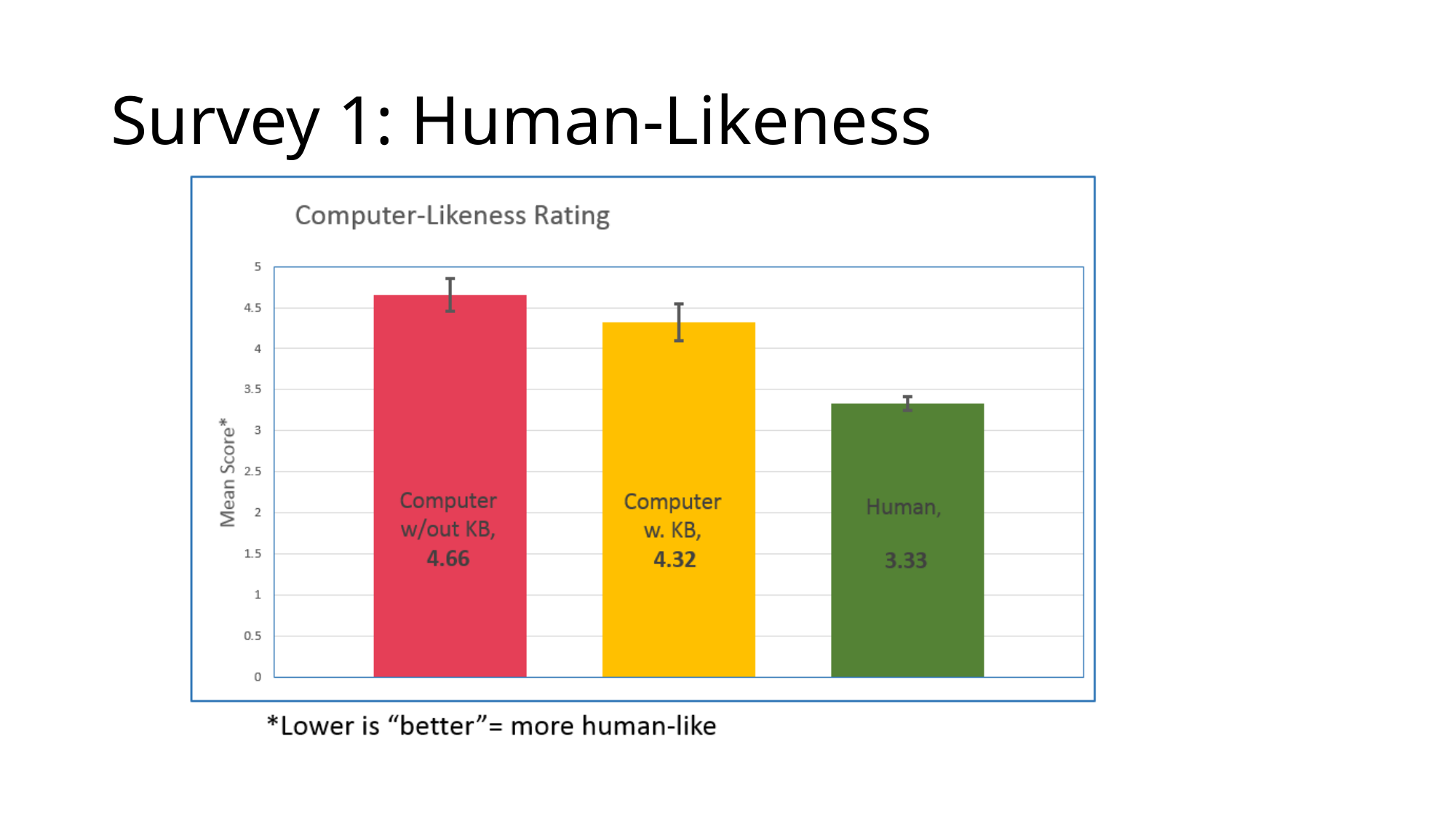
What is the label of the vertical axis of the chart? Mean Score* Is the value for Human greater or less than 3.5? less What is the mean Computer-Likeness Rating for Computer w. KB? 4.32 What is the difference between the Computer w/out KB rating and the Human rating? 1.33 What kind of chart is shown on the slide? Bar chart What is the mean Computer-Likeness Rating for Human? 3.33 What is the difference between the Computer w/out KB rating and the Computer w. KB rating? 0.34 How many categories are shown in the chart? 3 What is the mean Computer-Likeness Rating for Computer w/out KB? 4.66 Which category has the highest Computer-Likeness Rating? Computer w/out KB Which category has the lowest Computer-Likeness Rating? Human Which has a higher Computer-Likeness Rating, Computer w. KB or Human? Computer w. KB